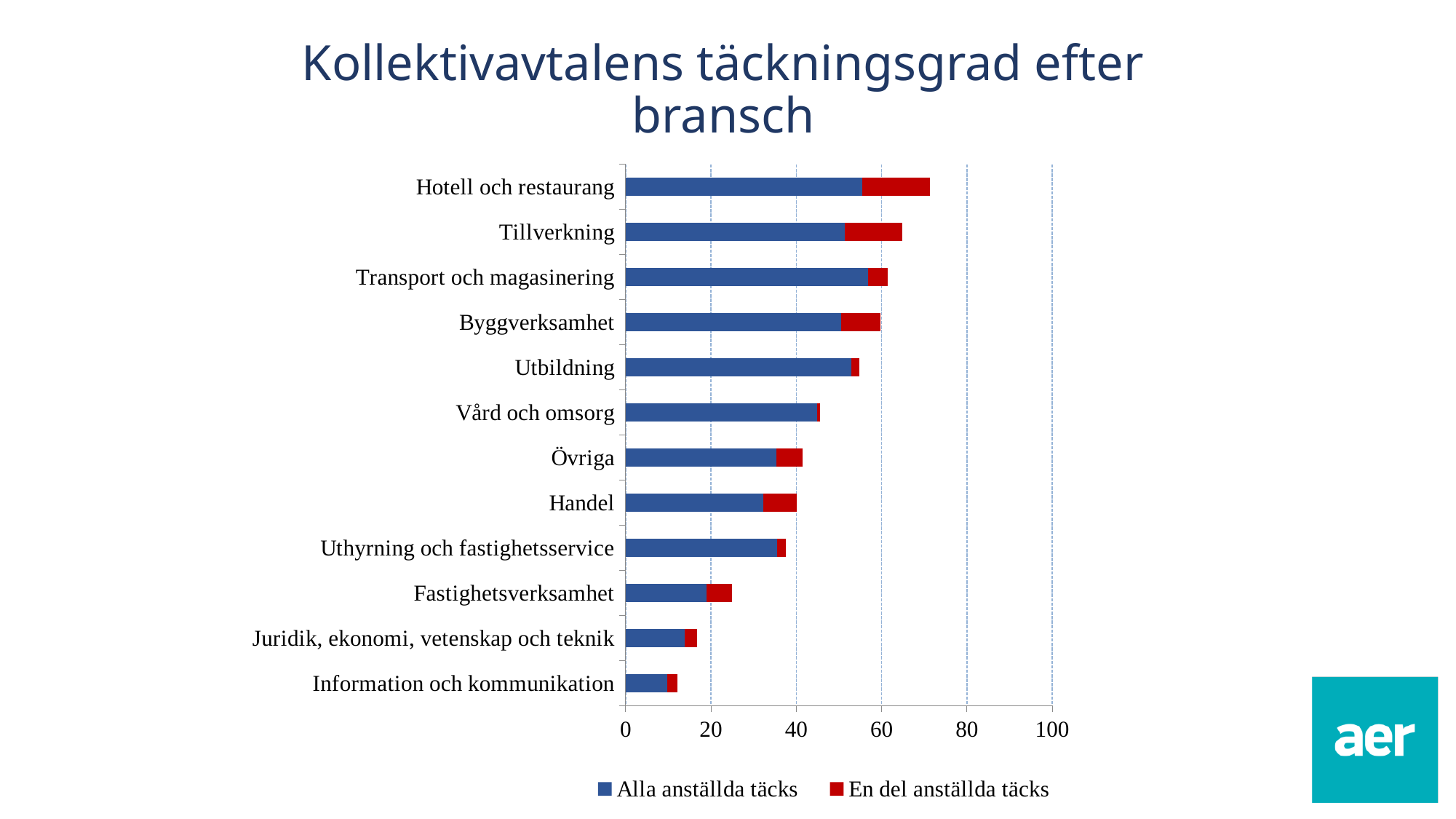
Which category has the longest total bar? Hotell och restaurang Which has the longer total bar, Tillverkning or Handel? Tillverkning Which colour represents the series 'En del anställda täcks' in the legend? red Which category has the shortest total bar? Information och kommunikation Is the total bar for Utbildning greater or less than 60? less What kind of chart is shown on the slide? bar chart Is the total bar for Fastighetsverksamhet greater or less than 20? greater Is the total bar for Hotell och restaurang greater or less than 60? greater Going from the top category to the bottom category, do the total bars get longer or shorter? shorter How many series does the legend list? 2 How many industry categories are plotted in the chart? 12